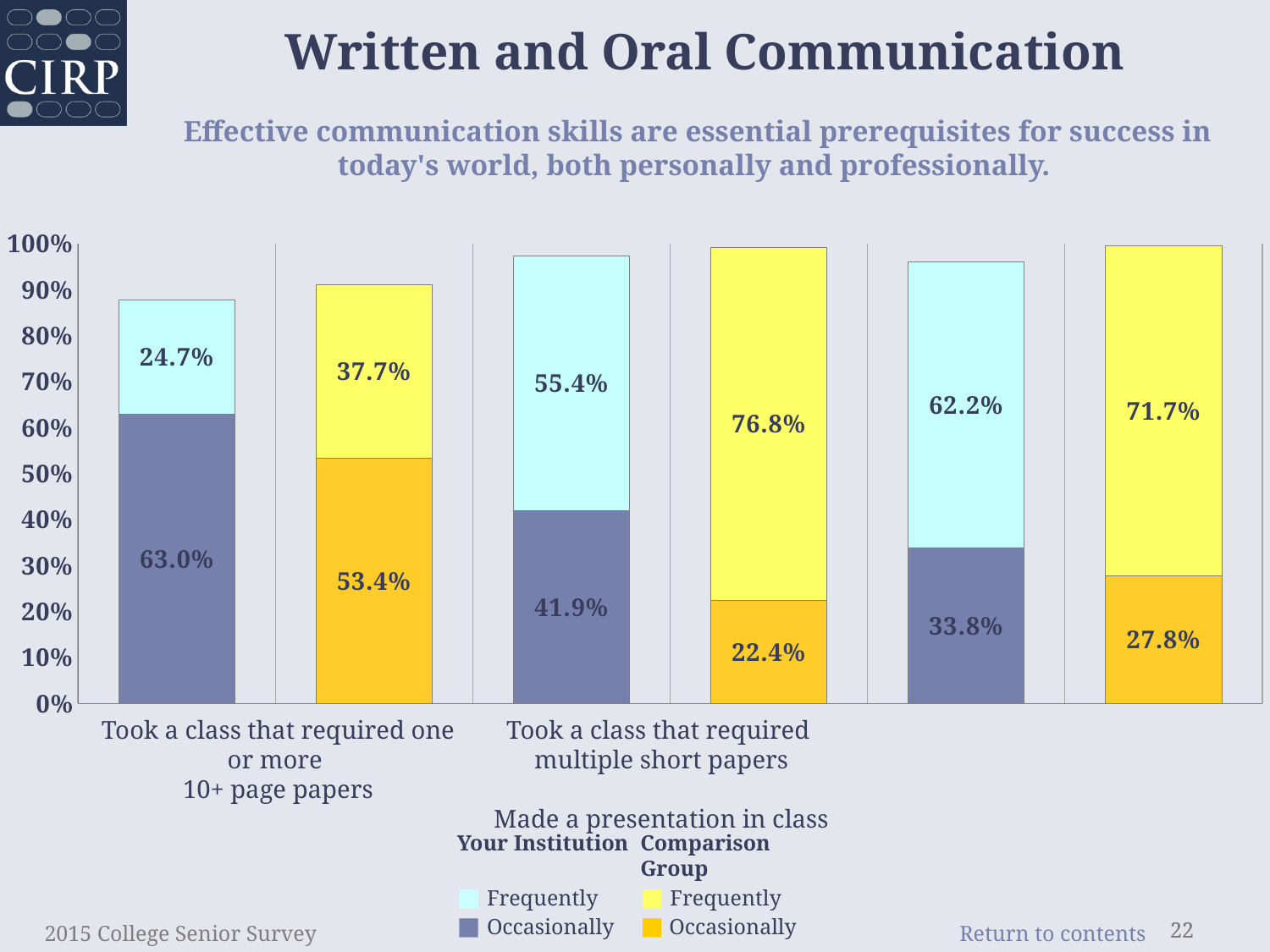
What percentage of Your Institution students occasionally made a presentation in class? 33.8% What percentage of the Comparison Group frequently made a presentation in class? 71.7% Which activity has the lowest 'Frequently' percentage for Your Institution? Took a class that required one or more 10+ page papers Which activity has the highest 'Frequently' percentage for the Comparison Group? Took a class that required multiple short papers What percentage of Your Institution students frequently took a class that required one or more 10+ page papers? 24.7% For making a presentation in class, which is larger: Your Institution's 'Occasionally' percentage or the Comparison Group's 'Occasionally' percentage? Your Institution What is the total (Frequently plus Occasionally) for Your Institution for taking a class that required one or more 10+ page papers? 87.7% What is the difference between the Comparison Group's and Your Institution's 'Frequently' percentages for taking a class that required multiple short papers? 21.4% What percentage of the Comparison Group occasionally took a class that required multiple short papers? 22.4% How many activity categories are shown on the x axis? 3 How many series does the legend list? 4 What kind of chart is shown on the slide? Stacked bar chart